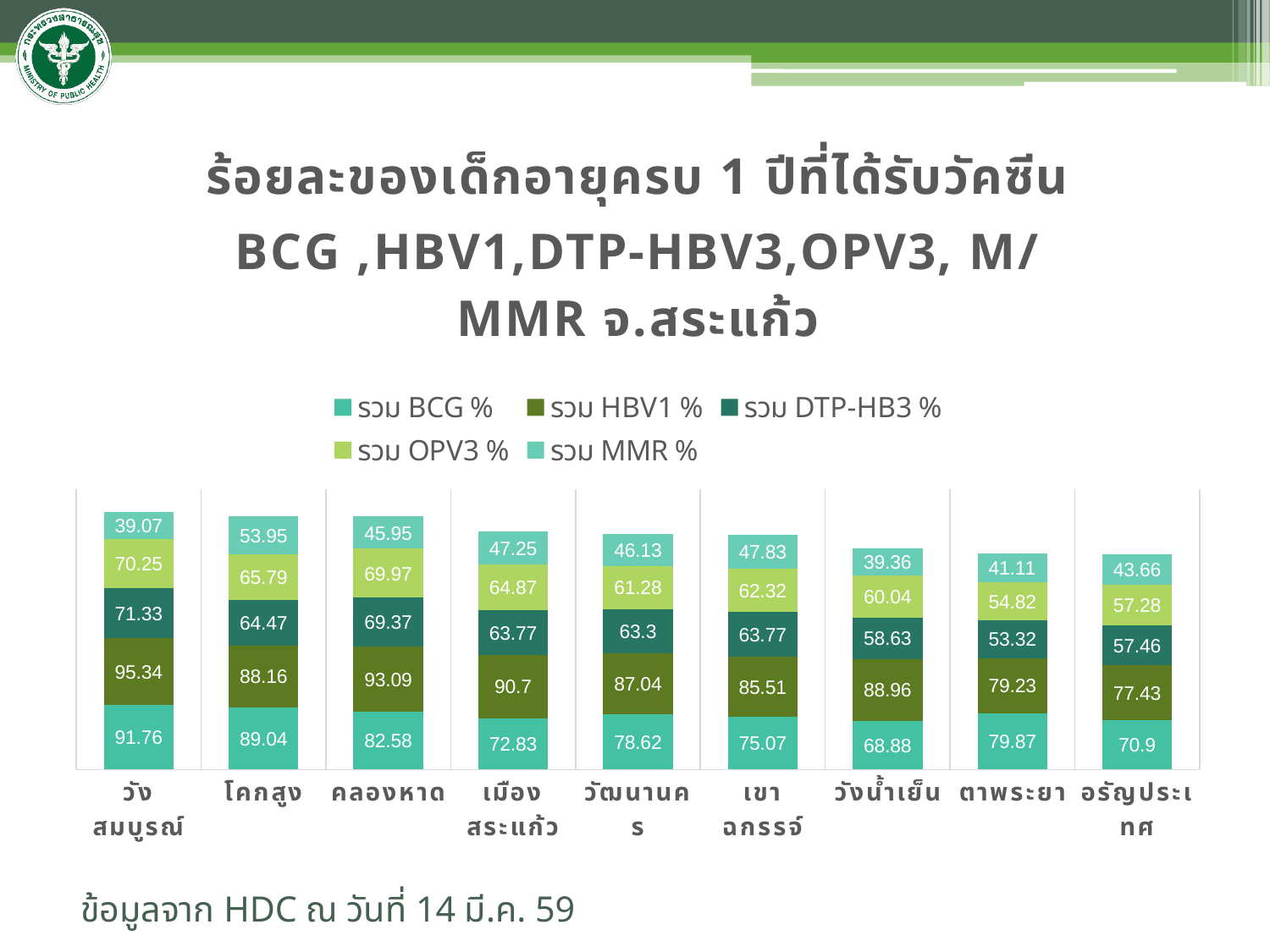
Which has the larger รวม HBV1 % value, คลองหาด or เมืองสระแก้ว? คลองหาด What kind of chart is shown on the slide? Stacked bar chart Which district has the lowest รวม BCG % value? วังน้ำเย็น How many districts are shown on the x axis? 9 What is the total of the stacked bar for ตาพระยา? 308.35 Which district has the highest รวม BCG % value? วังสมบูรณ์ What is the รวม BCG % value for วังสมบูรณ์? 91.76 What is the รวม MMR % value for โคกสูง? 53.95 How many series does the legend list? 5 What is the difference between the รวม BCG % values for วังสมบูรณ์ and โคกสูง? 2.72 What is the รวม DTP-HB3 % value for ตาพระยา? 53.32 What is the รวม HBV1 % value for คลองหาด? 93.09